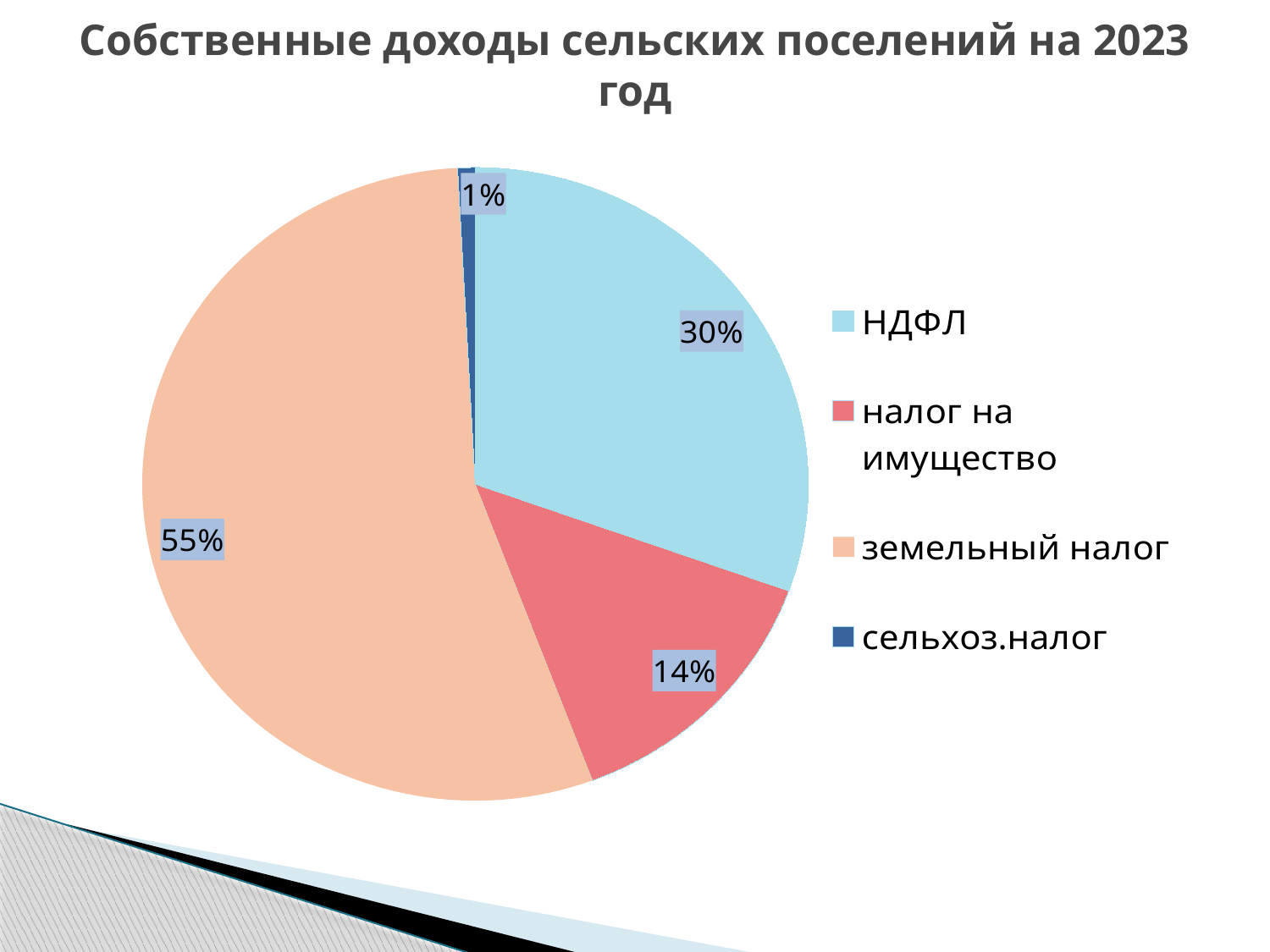
What is the value shown for налог на имущество? 14% What is the difference between the shares of земельный налог and НДФЛ? 25% How many categories are shown in the pie chart? 4 What is the title of the chart? Собственные доходы сельских поселений на 2023 год What share of the pie does земельный налог represent? 55% Which category has the largest share of the pie? земельный налог What is the value shown for сельхоз.налог? 1% What share of the pie does НДФЛ represent? 30% What kind of chart is shown on the slide? pie chart Which category has the smallest share of the pie? сельхоз.налог Which is larger, the share of НДФЛ or the share of налог на имущество? НДФЛ What colour is the slice for налог на имущество? red